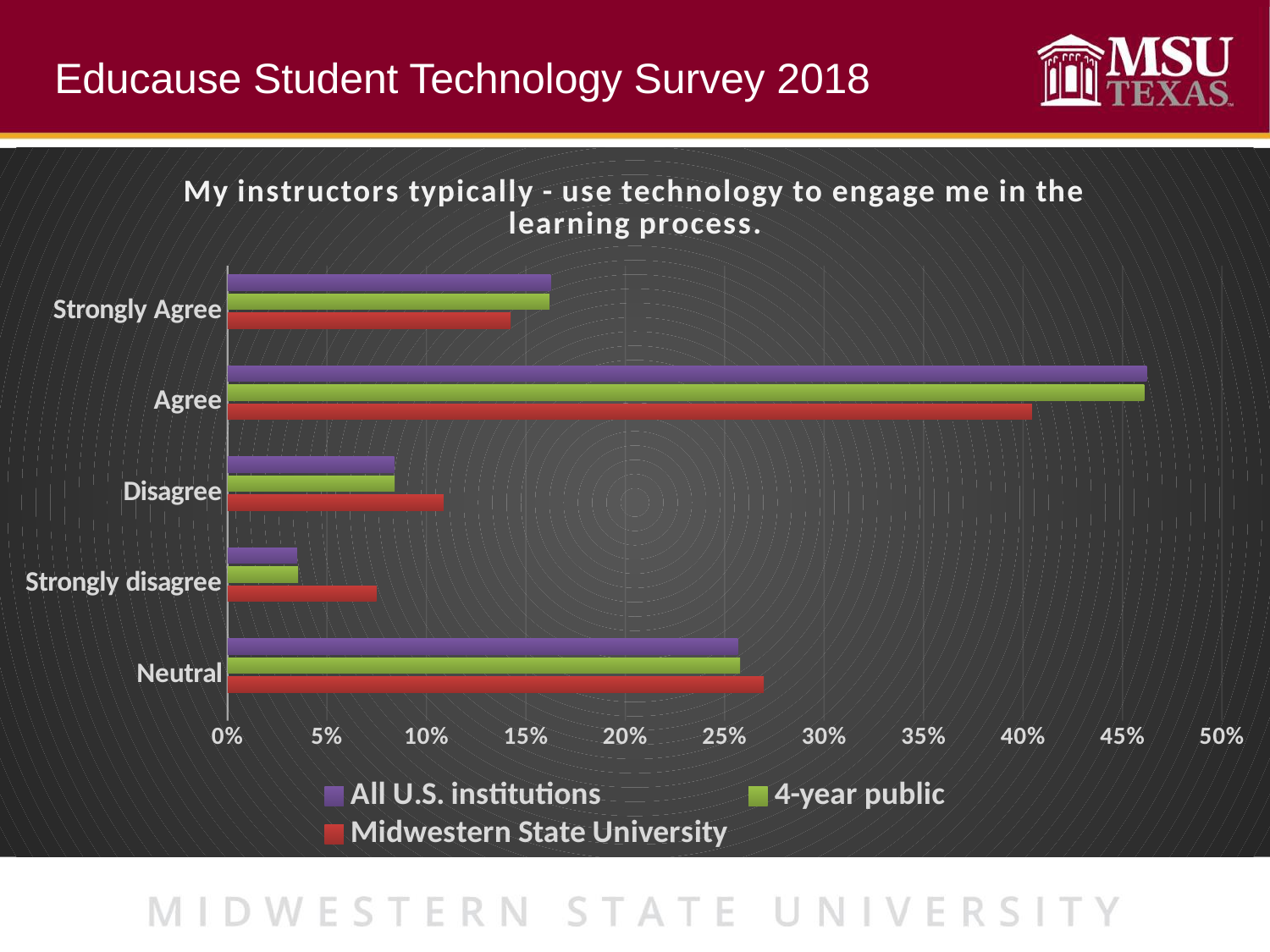
For Disagree, which is larger: Midwestern State University or All U.S. institutions? Midwestern State University Is the All U.S. institutions value for Agree greater or less than 40%? greater For Midwestern State University, which response category has the highest value? Agree What kind of chart is shown on the slide? bar chart For Agree, which is larger: All U.S. institutions or Midwestern State University? All U.S. institutions Is the Midwestern State University value for Neutral greater or less than 25%? greater Is the Midwestern State University value for Strongly disagree greater or less than 10%? less How many series does the legend list? 3 How many response categories are shown on the chart? 5 For Midwestern State University, which response category has the lowest value? Strongly disagree What colour are the bars for Midwestern State University? red